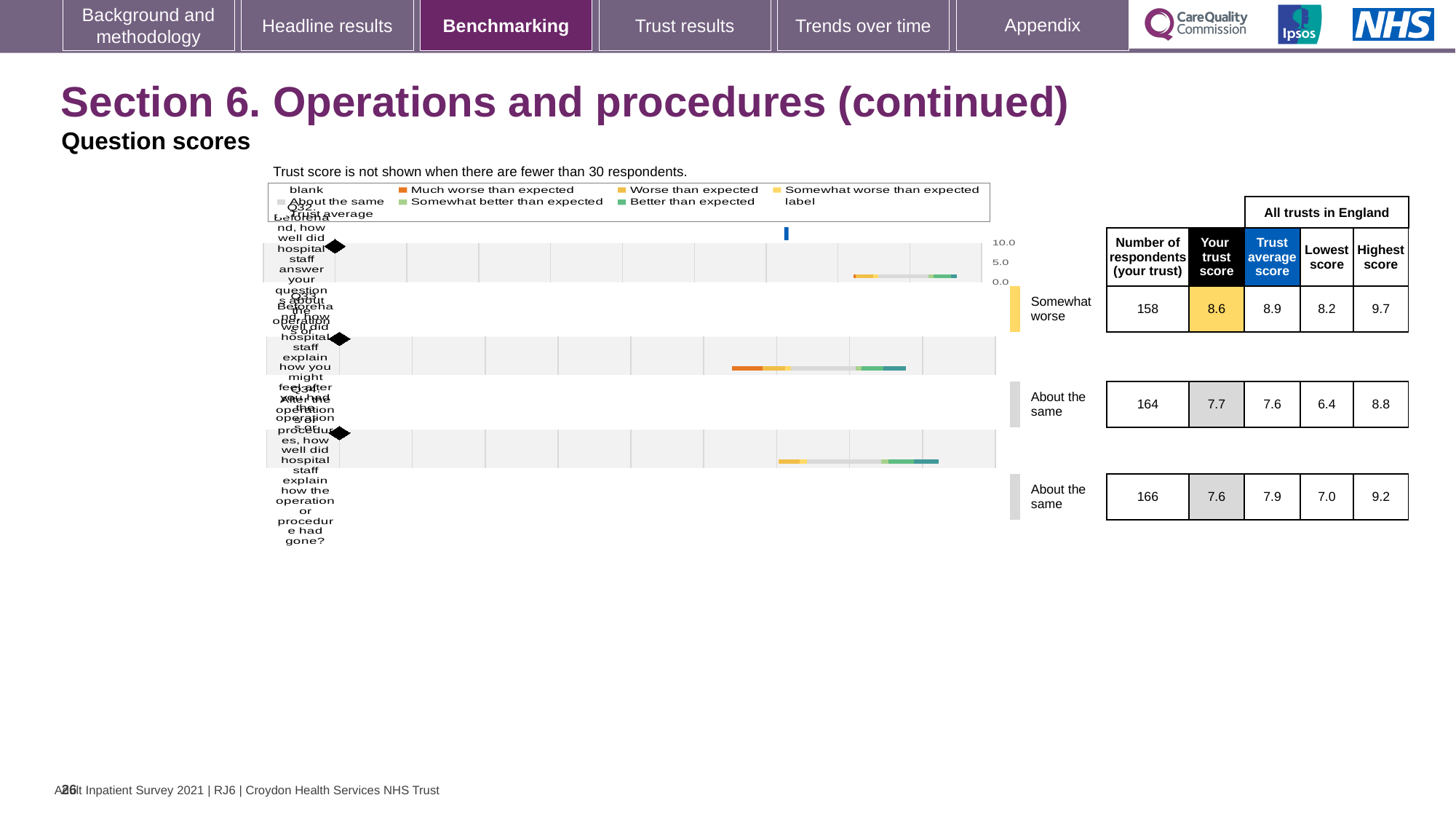
What kind of chart is shown on the slide? bar chart In the table beside the chart, what is the trust average score for the second (middle) row? 7.6 How many question rows are plotted in the chart? 3 In the table beside the chart, what is the number of respondents for the first (top) row? 158 In the table beside the chart, what is the 'Your trust score' for the first (top) row? 8.6 What benchmark category label is shown next to the first (top) row of the chart? Somewhat worse For the second (middle) row, what is the difference between 'Your trust score' and 'Trust average score'? 0.1 In the table beside the chart, what is the lowest score for the second (middle) row? 6.4 In the table beside the chart, what is the highest score for the third (bottom) row? 9.2 For the first (top) row, which is larger: 'Your trust score' or 'Trust average score'? Trust average score For the third (bottom) row, what is the difference between the highest score and the lowest score? 2.2 Which row has the highest 'Your trust score'? the first (top) row